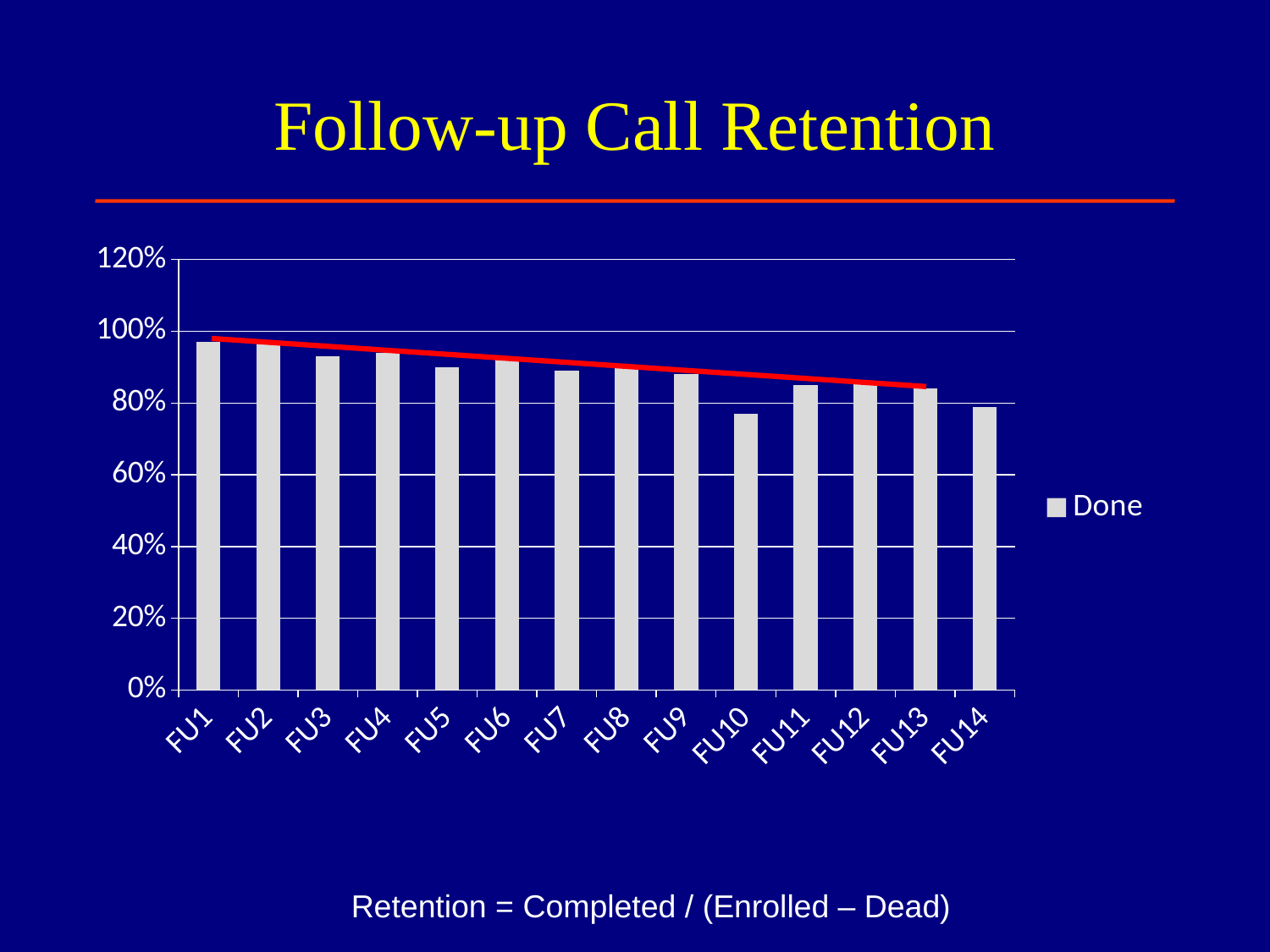
How many follow-up call categories are plotted on the x axis? 14 Which has the larger value, FU1 or FU10? FU1 What kind of chart is shown on the slide? bar chart Is the value for FU1 greater or less than 80%? greater What is the title of the chart? Follow-up Call Retention Which has the larger value, FU14 or FU3? FU3 How many series does the legend list? 1 What is the name of the series shown in the legend? Done Is the value for FU5 greater or less than 80%? greater Is the value for FU10 greater or less than 80%? less Do the retention values generally rise or fall from FU1 to FU14? fall